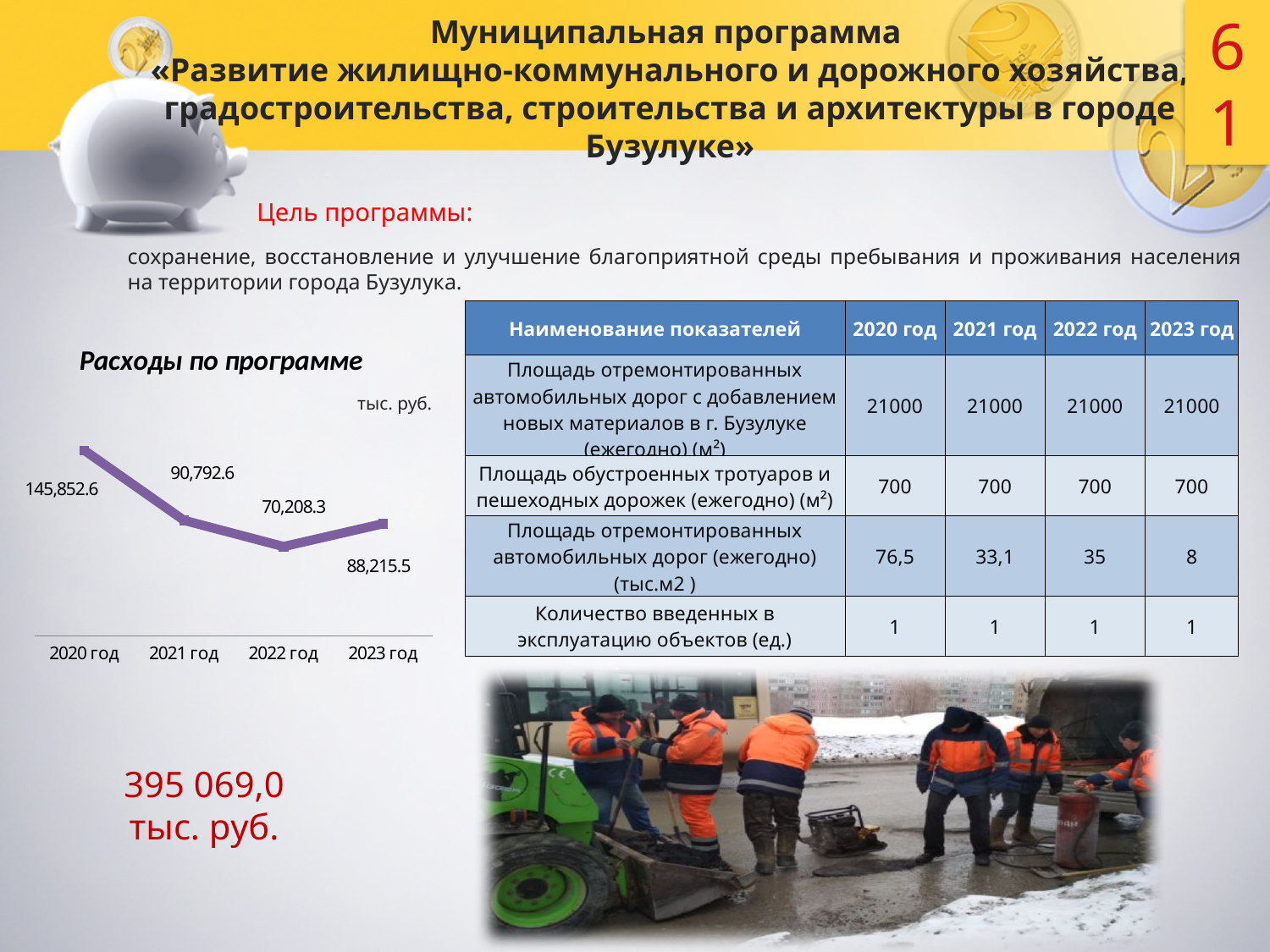
What type of chart is used to show 'Расходы по программе'? line chart In the 'Расходы по программе' chart, which year has the highest value? 2020 год In the 'Расходы по программе' chart, what is the value for 2020 год? 145,852.6 In the 'Расходы по программе' chart, which is larger: the value for 2021 год or the value for 2023 год? 2021 год In the 'Расходы по программе' chart, what is the value for 2021 год? 90,792.6 In the 'Расходы по программе' chart, what is the difference between the values for 2023 год and 2022 год? 18,007.2 In the 'Расходы по программе' chart, what is the value for 2023 год? 88,215.5 How many years are plotted in the 'Расходы по программе' chart? 4 In the 'Расходы по программе' chart, what is the difference between the values for 2020 год and 2021 год? 55,060.0 In the 'Расходы по программе' chart, what is the value for 2022 год? 70,208.3 In the 'Расходы по программе' chart, do the values rise or fall from 2020 год to 2022 год? fall In the 'Расходы по программе' chart, which year has the lowest value? 2022 год